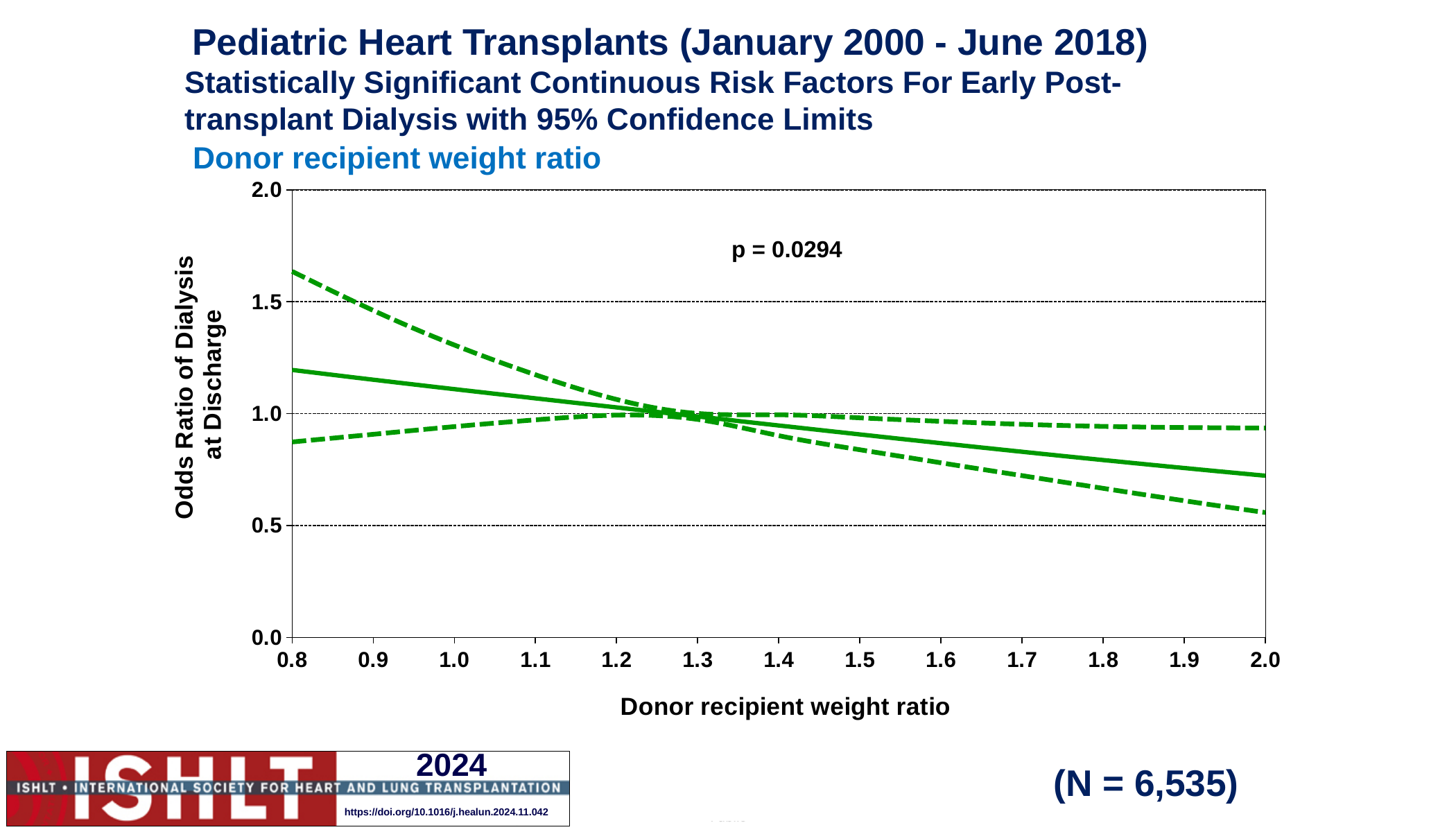
Is the odds ratio (solid line) at a donor recipient weight ratio of 0.8 greater or less than 1.0? greater Is the odds ratio (solid line) higher at a donor recipient weight ratio of 0.8 or at 2.0? 0.8 Is the lower 95% confidence limit (lower dashed line) at a donor recipient weight ratio of 0.8 greater or less than 1.0? less How many tick marks are labelled on the x axis of the chart? 13 Is the lower 95% confidence limit (lower dashed line) at a donor recipient weight ratio of 2.0 greater or less than 0.5? greater What p-value is printed on the chart? p = 0.0294 What is the label of the y axis of the chart? Odds Ratio of Dialysis at Discharge What kind of chart is shown on the slide? line chart Does the solid odds ratio line rise or fall as the donor recipient weight ratio increases from 0.8 to 2.0? fall